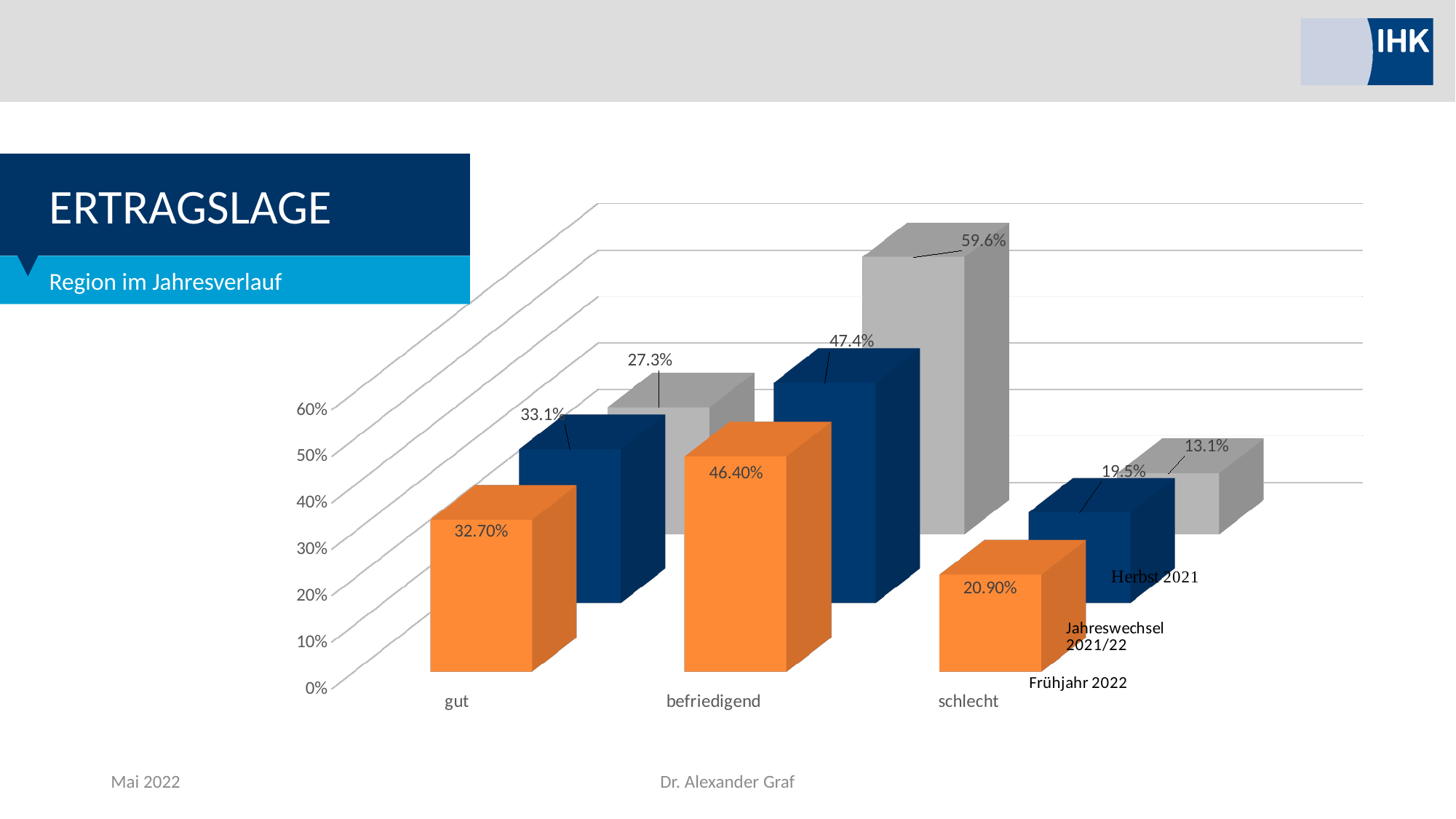
Which is larger for "schlecht": the Herbst 2021 value or the Frühjahr 2022 value? Frühjahr 2022 What is the value for "befriedigend" in the Herbst 2021 series? 59.6% What is the value for "befriedigend" in the Frühjahr 2022 series? 46.40% What is the difference between the Herbst 2021 and Jahreswechsel 2021/22 values for "befriedigend"? 12.2% What is the value for "schlecht" in the Jahreswechsel 2021/22 series? 19.5% How many categories are shown on the x axis? 3 Which category has the lowest value in the Herbst 2021 series? schlecht What is the value for "gut" in the Herbst 2021 series? 27.3% Which category has the highest value in the Frühjahr 2022 series? befriedigend What is the title shown above the chart on the slide? ERTRAGSLAGE How many data series does the chart show? 3 What kind of chart is shown on the slide? bar chart